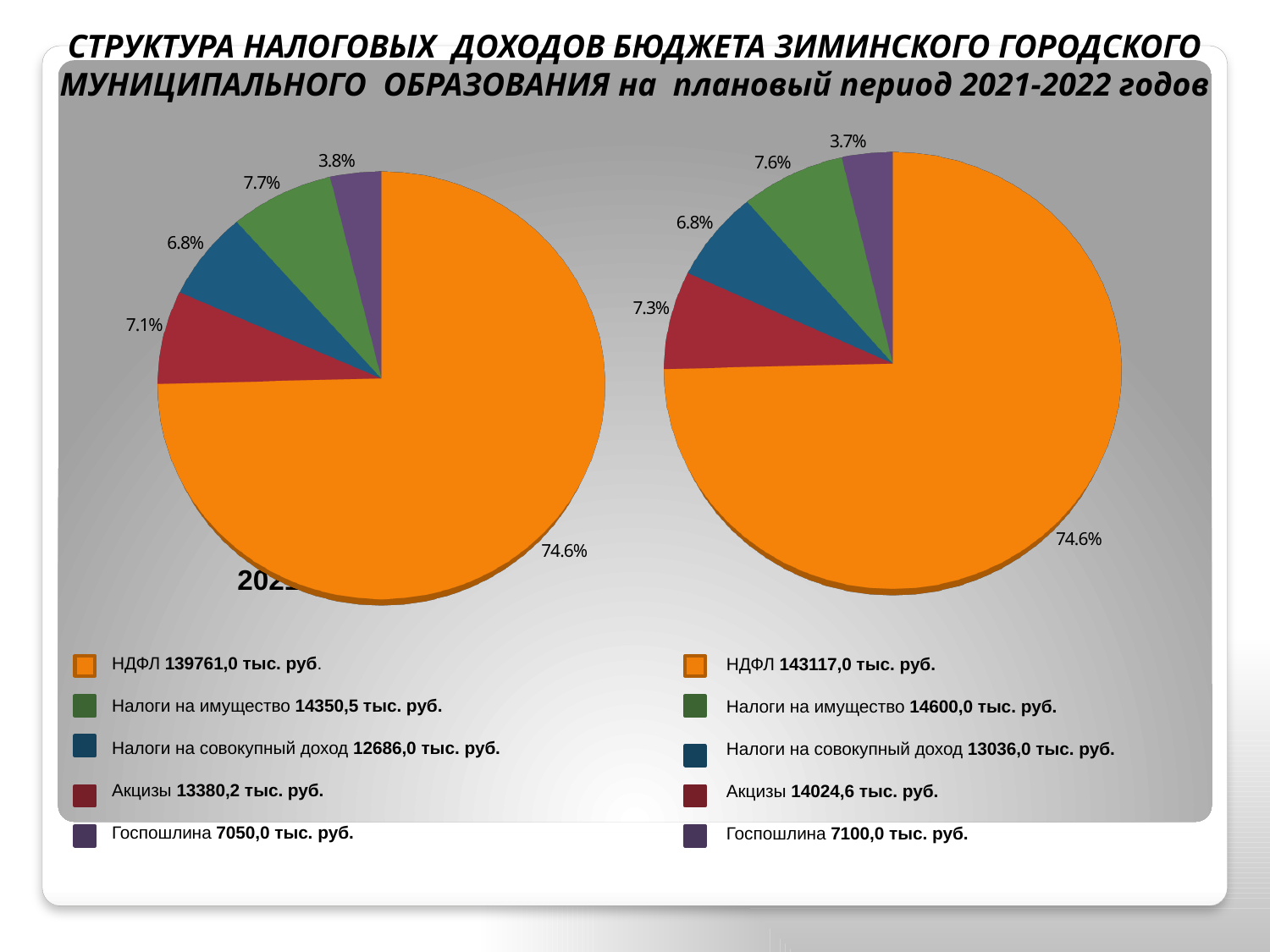
On the right pie chart, what share does the Налоги на имущество slice have? 7.6% How many slices does the left pie chart have? 5 According to the legend of the right pie chart, what is the value for НДФЛ? 143117,0 тыс. руб. On the left pie chart, what share does the Акцизы slice have? 7.1% On the left pie chart, what share does the НДФЛ slice have? 74.6% On the left pie chart, what is the difference in percentage points between the Налоги на имущество slice and the Налоги на совокупный доход slice? 0.9 According to the legend of the left pie chart, what is the value for Госпошлина? 7050,0 тыс. руб. On the right pie chart, which slice is larger: Акцизы or Налоги на совокупный доход? Акцизы On the left pie chart, which category has the largest slice? НДФЛ On the right pie chart, which category has the smallest slice? Госпошлина What type of chart is shown on the right side of the slide? Pie chart